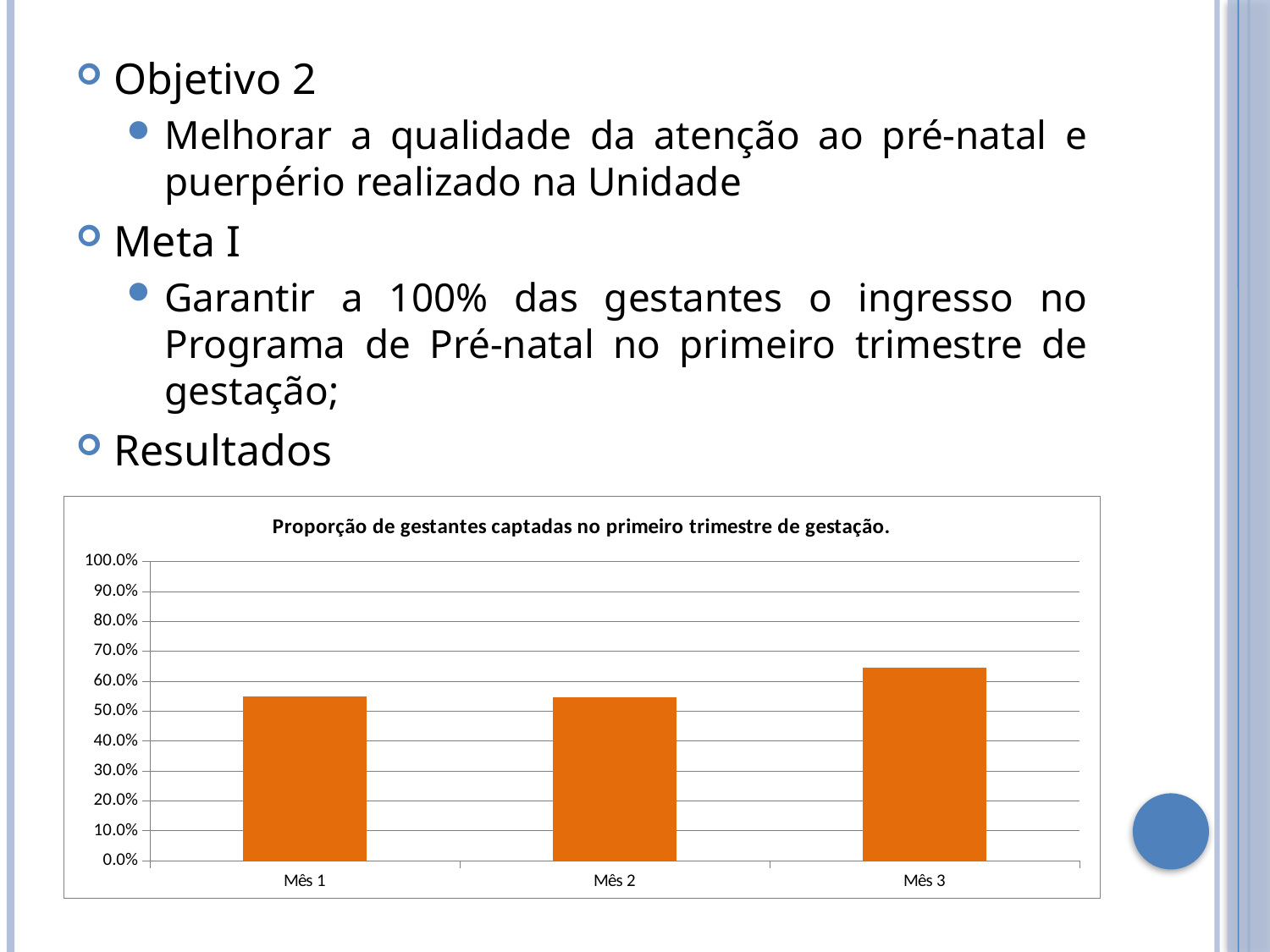
How many categories (months) are plotted on the x axis of the chart? 3 Which is larger, the value for Mês 2 or the value for Mês 3? Mês 3 Is the value for Mês 2 greater or less than 50.0%? greater What is the title of the chart? Proporção de gestantes captadas no primeiro trimestre de gestação. Is the value for Mês 1 greater or less than 50.0%? greater Is the value for Mês 3 greater or less than 70.0%? less Which month has the highest proportion of pregnant women captured in the first trimester? Mês 3 What is the maximum value shown on the chart's vertical axis? 100.0% Which is larger, the value for Mês 3 or the value for Mês 1? Mês 3 What kind of chart is shown on the slide? bar chart